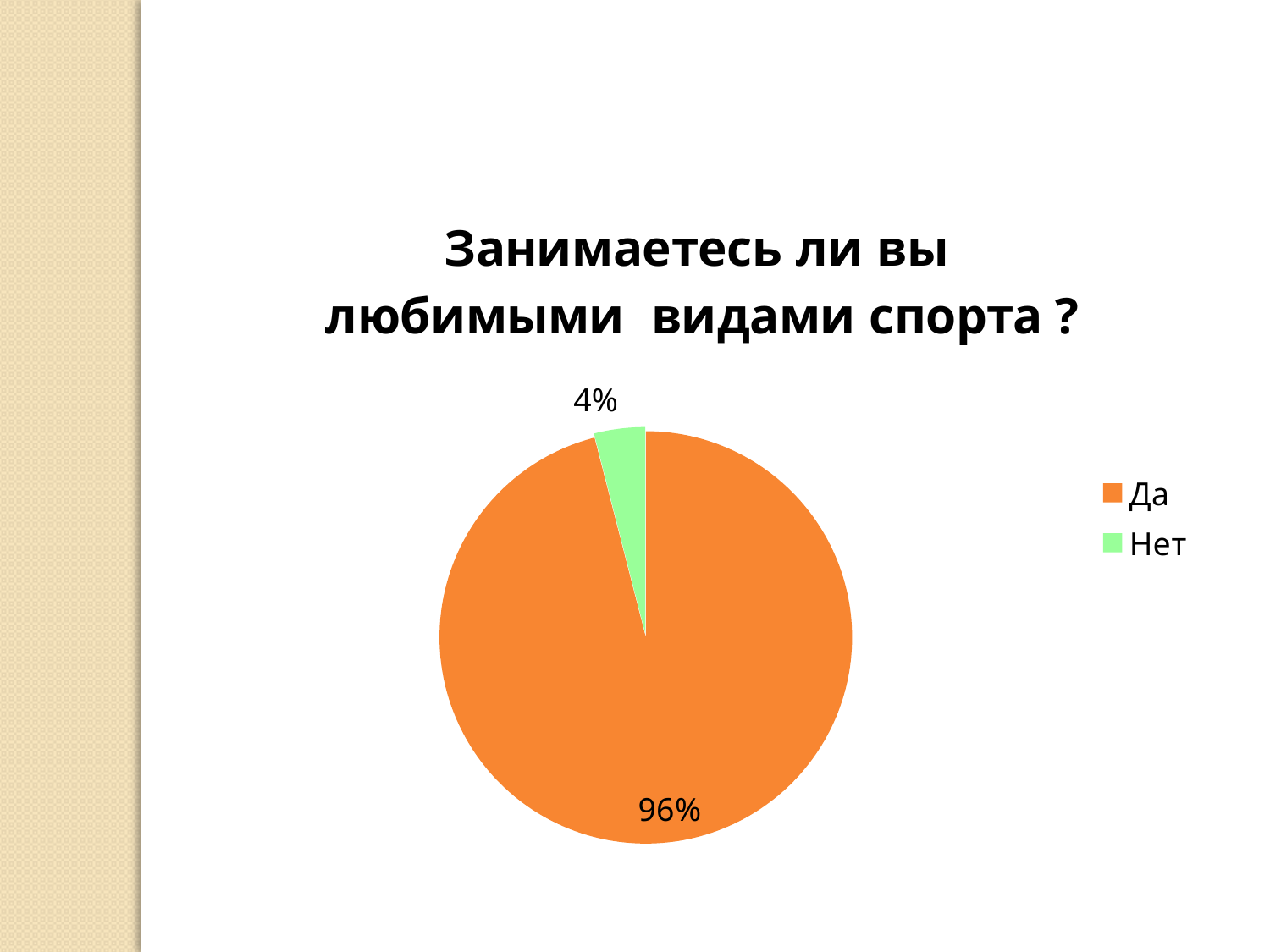
How many entries does the legend list? 2 What share of the pie does "Нет" take? 4% What is the difference in percentage points between the "Да" and "Нет" slices? 92 What share of the pie does "Да" take? 96% Which is larger, the "Да" slice or the "Нет" slice? Да What colour is the "Нет" slice? green What is the title of the chart? Занимаетесь ли вы любимыми видами спорта ? What kind of chart is shown on the slide? pie chart Which category has the smallest slice? Нет Which category has the largest slice? Да How many categories does the pie chart have? 2